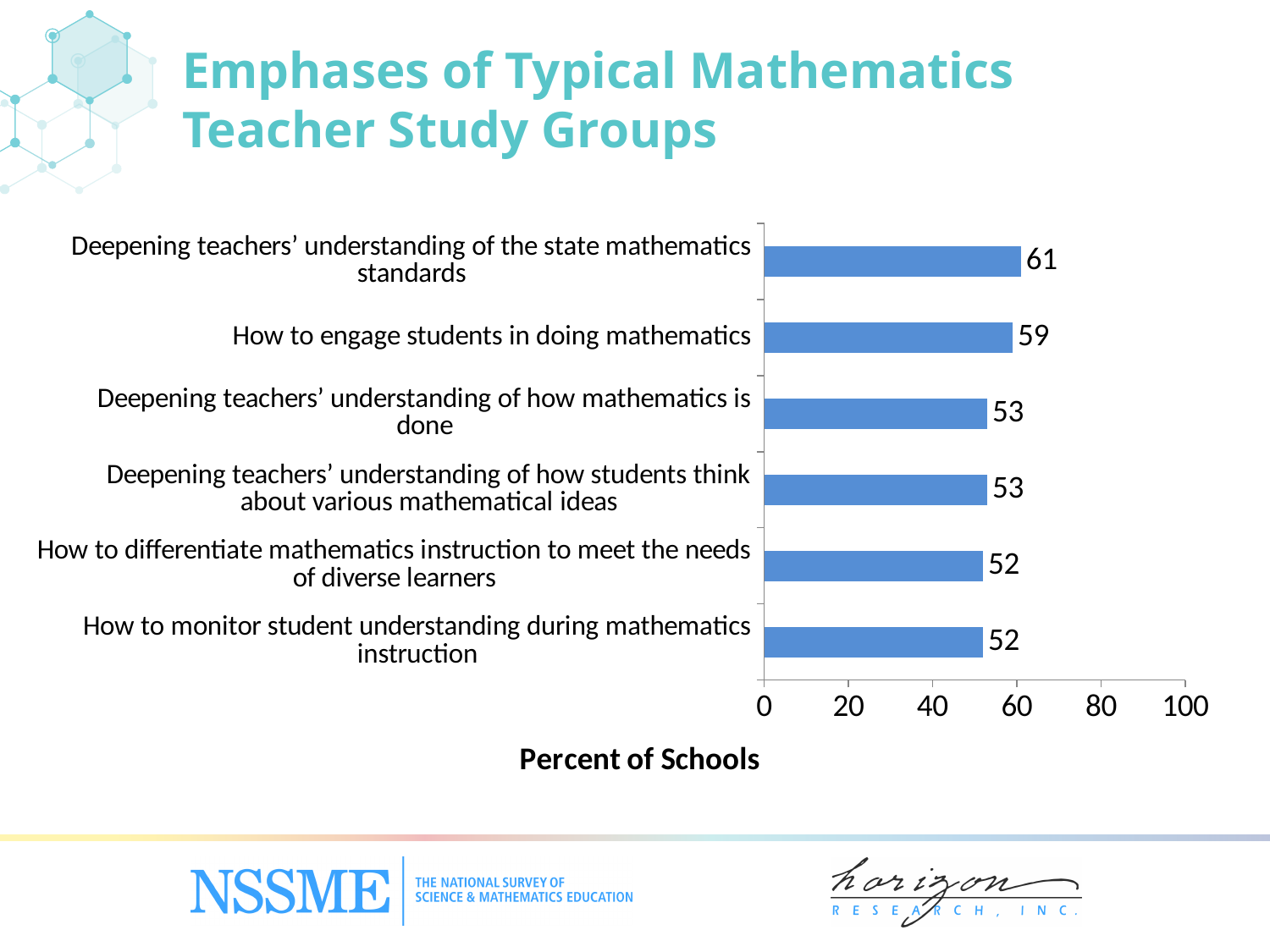
What is the label of the horizontal axis? Percent of Schools What percent of schools reported an emphasis on deepening teachers' understanding of the state mathematics standards? 61 What is the difference between the values for 'Deepening teachers' understanding of the state mathematics standards' and 'How to engage students in doing mathematics'? 2 What is the difference between the highest value and the lowest value shown on the chart? 9 What is the value for 'How to engage students in doing mathematics'? 59 What kind of chart is shown on the slide? bar chart Is the value for 'How to differentiate mathematics instruction to meet the needs of diverse learners' greater or less than 60? less What is the title of the slide? Emphases of Typical Mathematics Teacher Study Groups Which category has the highest percent of schools? Deepening teachers' understanding of the state mathematics standards What is the value for 'How to monitor student understanding during mathematics instruction'? 52 How many categories are shown on the chart? 6 Which is larger: the value for 'How to engage students in doing mathematics' or the value for 'Deepening teachers' understanding of how mathematics is done'? How to engage students in doing mathematics